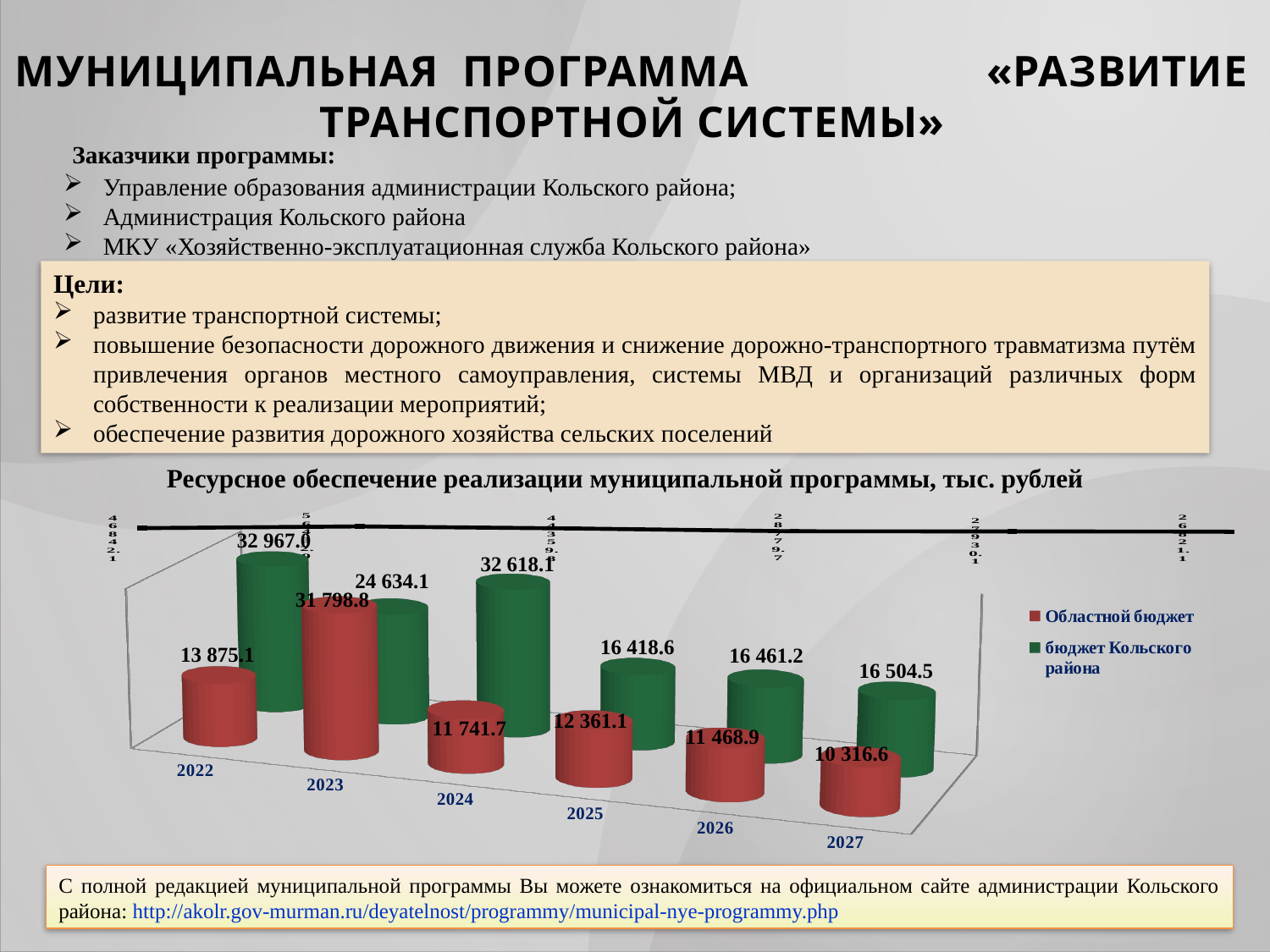
What is the value for Областной бюджет in 2022? 13 875.1 What is the value for бюджет Кольского района in 2027? 16 504.5 What kind of chart is shown on the slide? Bar chart In 2025, which is larger: Областной бюджет or бюджет Кольского района? бюджет Кольского района In which year is the Областной бюджет value the lowest? 2027 What is the difference between Областной бюджет and бюджет Кольского района in 2023? 7 164.7 In which year is the Областной бюджет value the highest? 2023 What is the value for бюджет Кольского района in 2024? 32 618.1 In which year is the бюджет Кольского района value the highest? 2022 How many series does the chart legend list? 2 How many years are shown on the x axis of the chart? 6 Do the бюджет Кольского района values rise or fall from 2025 to 2027? Rise